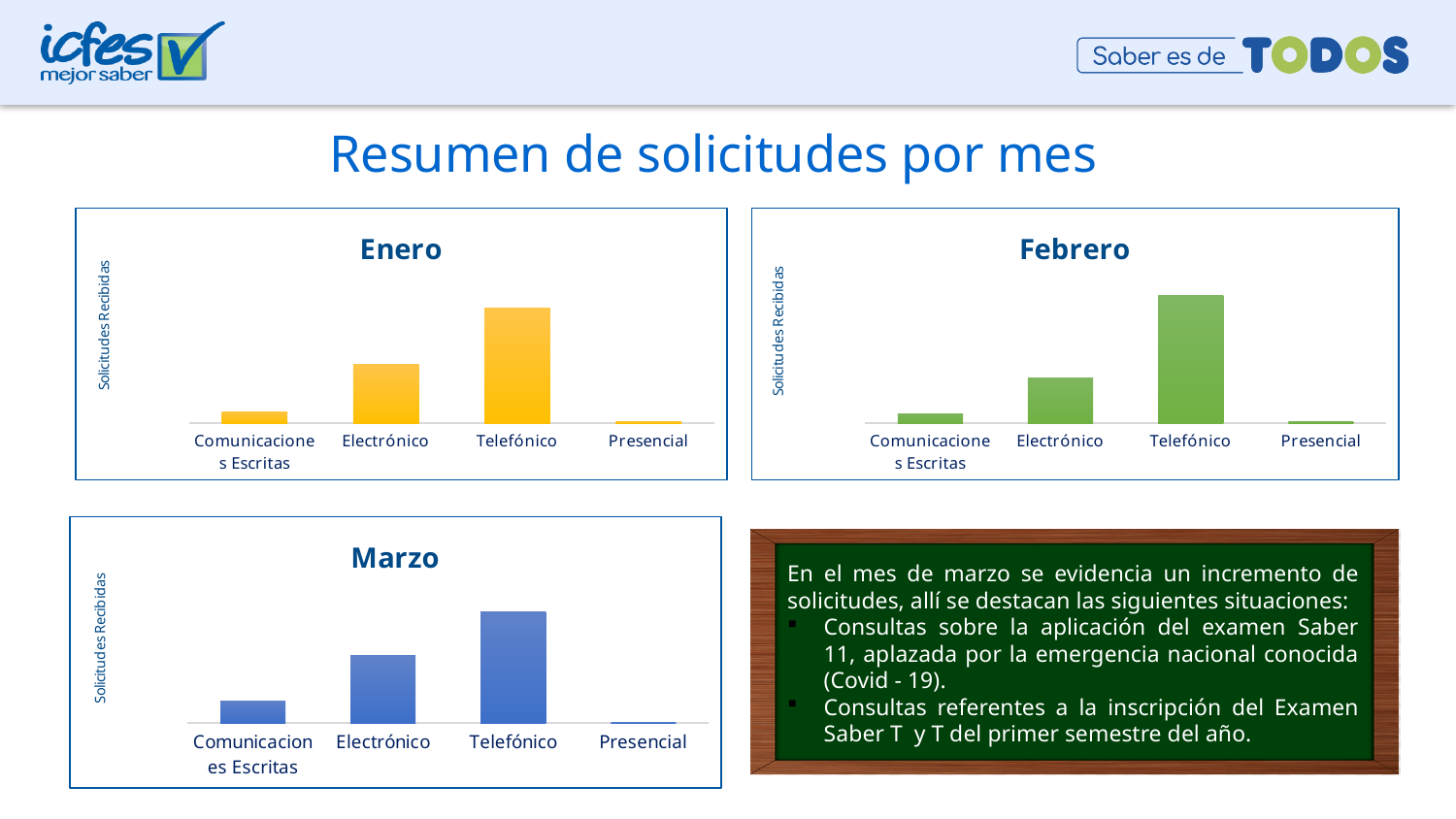
In the Marzo chart, which category has the lowest value? Presencial In the Enero chart, which is larger: Electrónico or Comunicaciones Escritas? Electrónico In the Enero chart, which category has the highest number of solicitudes recibidas? Telefónico In the Enero chart, which category has the lowest number of solicitudes recibidas? Presencial What colour are the bars in the Febrero chart? Green In the Febrero chart, which category has the highest value? Telefónico In the Febrero chart, which category has the lowest value? Presencial In the Marzo chart, which category has the highest value? Telefónico What is the y-axis label of the Enero chart? Solicitudes Recibidas How many categories are shown on the x axis of the Febrero chart? 4 What type of chart is the Marzo chart? Bar chart In the Marzo chart, which is larger: Comunicaciones Escritas or Electrónico? Electrónico